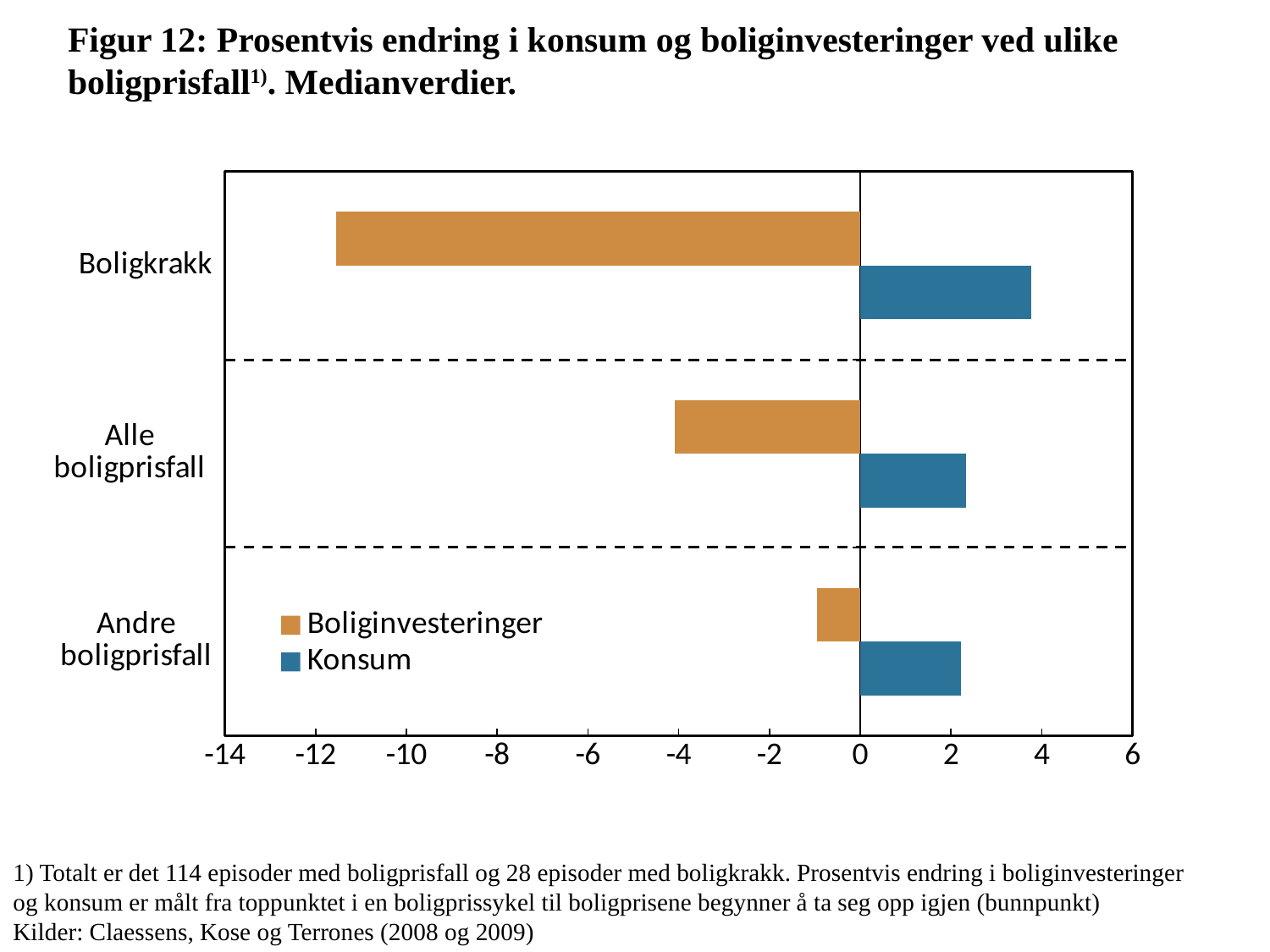
Which category has the lowest (most negative) Boliginvesteringer value? Boligkrakk How many series does the legend list? 2 Which category has the highest Konsum value? Boligkrakk Which is larger, the Konsum value for Boligkrakk or the Konsum value for Alle boligprisfall? Boligkrakk How many categories are shown on the vertical axis of the chart? 3 Is the Boliginvesteringer value for Andre boligprisfall greater or less than -2? greater What colour are the Konsum bars? Blue Is the Boliginvesteringer value for Alle boligprisfall greater or less than -2? less Is the Boliginvesteringer value for Boligkrakk greater or less than -10? less What kind of chart is shown on the slide? Bar chart Which two series are listed in the legend? Boliginvesteringer and Konsum